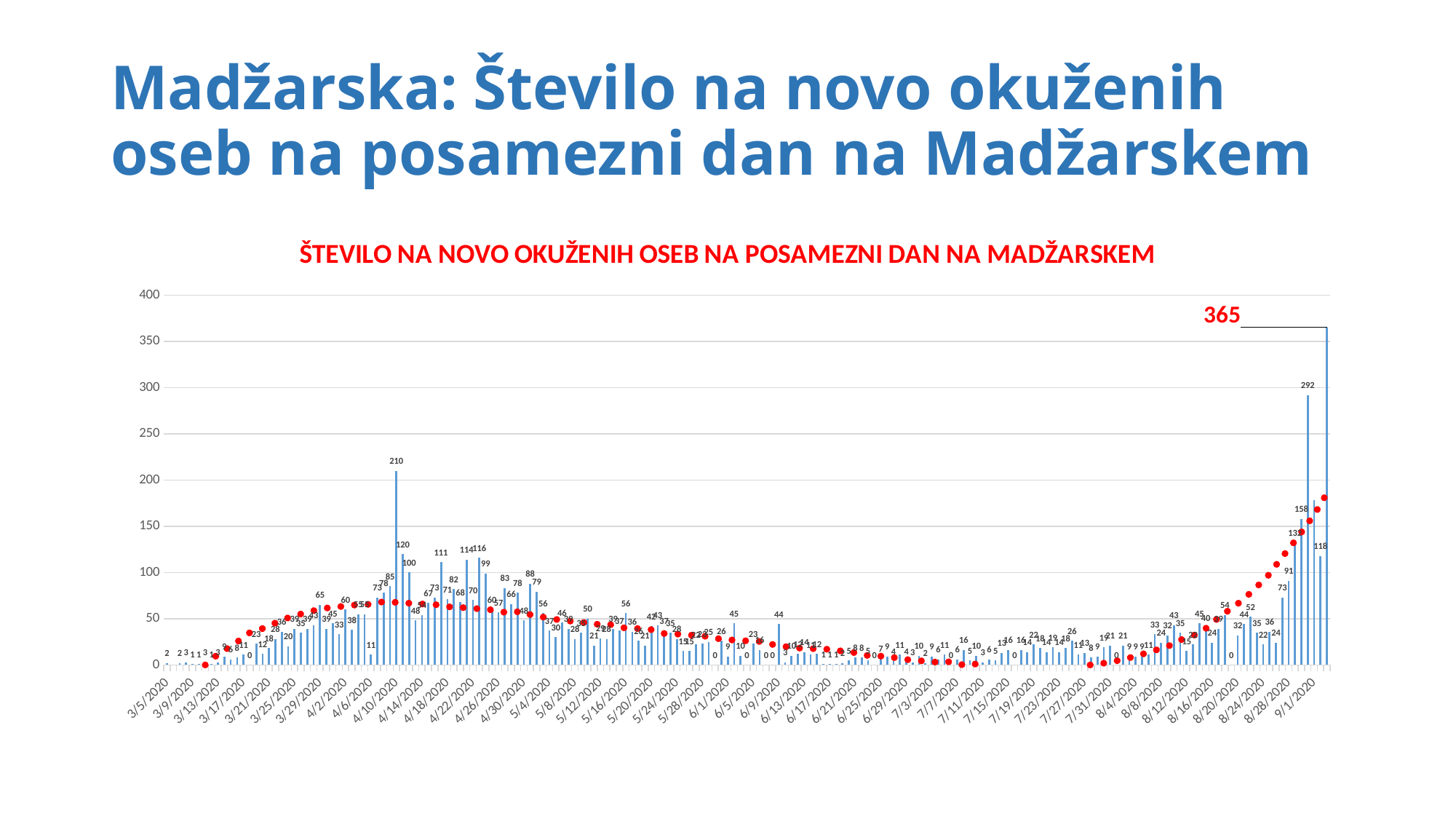
What is the difference between the highest bar (365) and the April peak of 210? 155 What is the highest tick value on the vertical axis? 400 What is the value of the tallest bar in April, near 4/10/2020? 210 Which is larger, the bar labeled 292 or the bar labeled 210? 292 What is the difference between the highest bar (365) and the bar labeled 292? 73 What is the title of the chart? ŠTEVILO NA NOVO OKUŽENIH OSEB NA POSAMEZNI DAN NA MADŽARSKEM What kind of chart is shown on the slide? bar chart Do the values generally rise or fall from 8/4/2020 to 9/1/2020? rise What is the value of the second-tallest bar, the one just before the 365 bar? 292 What is the highest value shown on the chart? 365 Is the highest bar on the chart greater or less than 350? greater